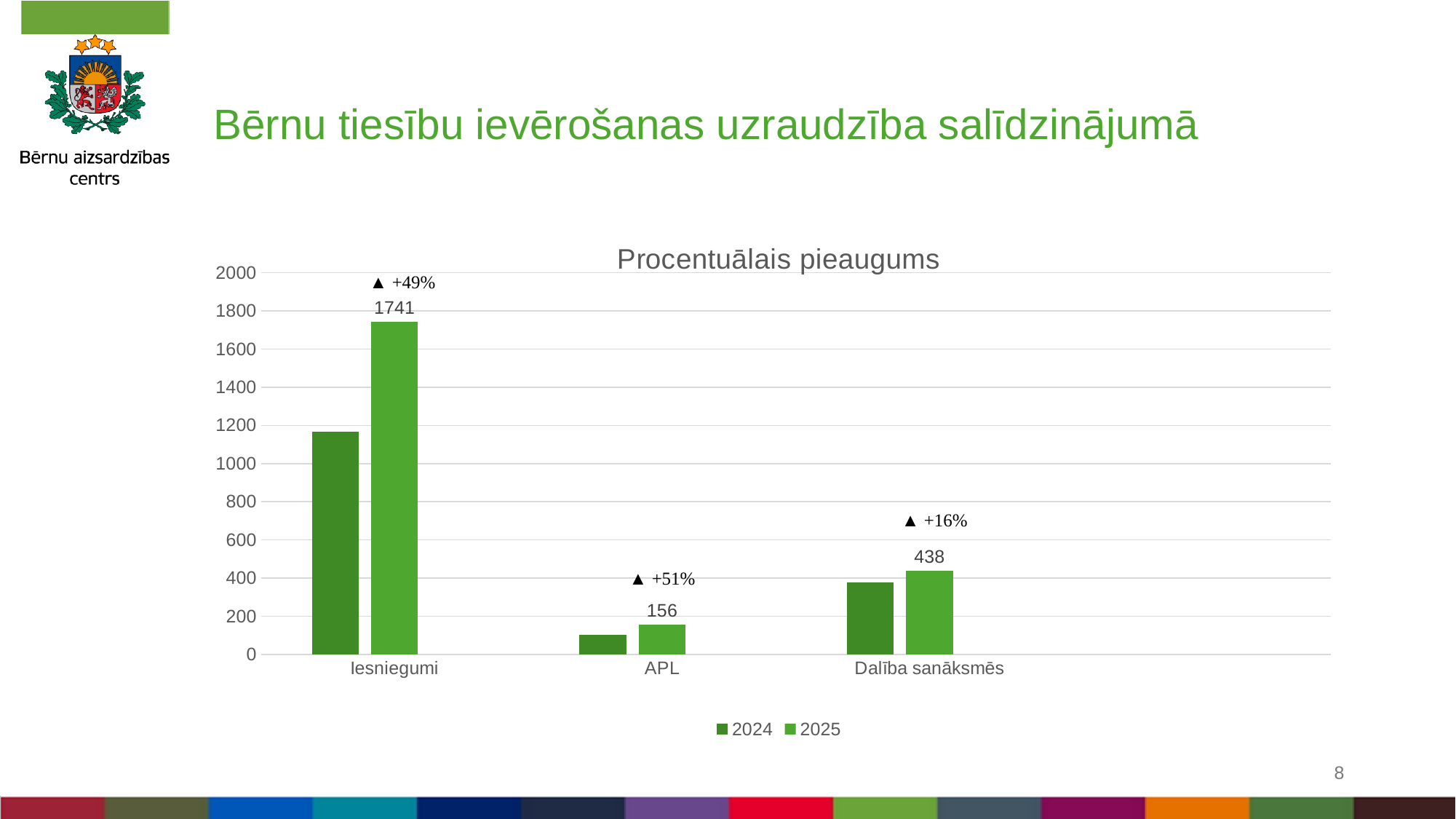
What percentage increase is shown above the Iesniegumi bars? +49% How many series does the legend list? 2 Which category has the lowest 2025 value? APL Is the 2024 value for Dalība sanāksmēs greater or less than 400? less How many categories are shown on the x axis? 3 What is the 2025 value for Iesniegumi? 1741 Is the 2024 value for Iesniegumi greater or less than 1000? greater What is the 2025 value for APL? 156 What is the 2025 value for Dalība sanāksmēs? 438 What is the title of the chart? Procentuālais pieaugums What percentage increase is shown above the APL bars? +51% Which category has the highest 2025 value? Iesniegumi